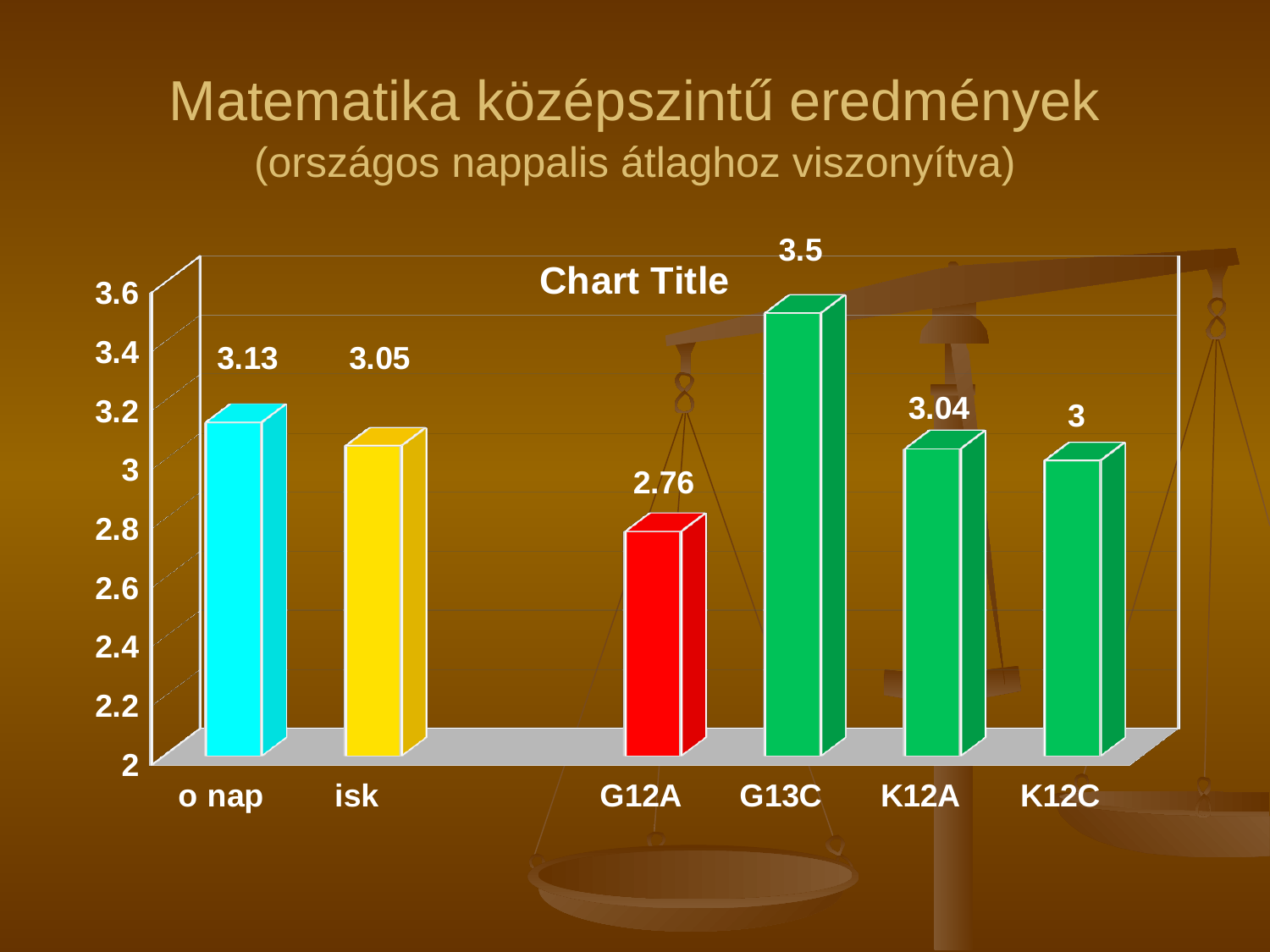
What is the value for K12C? 3 How many categories are shown on the x axis? 6 Which is larger, the value for isk or the value for K12A? isk Which category has the highest value? G13C What is the difference between the values for o nap and isk? 0.08 Which category has the lowest value? G12A What is the title printed inside the chart area? Chart Title What is the value for K12A? 3.04 What is the value for o nap? 3.13 What is the difference between the values for G13C and G12A? 0.74 What is the value for G12A? 2.76 What kind of chart is shown on the slide? bar chart